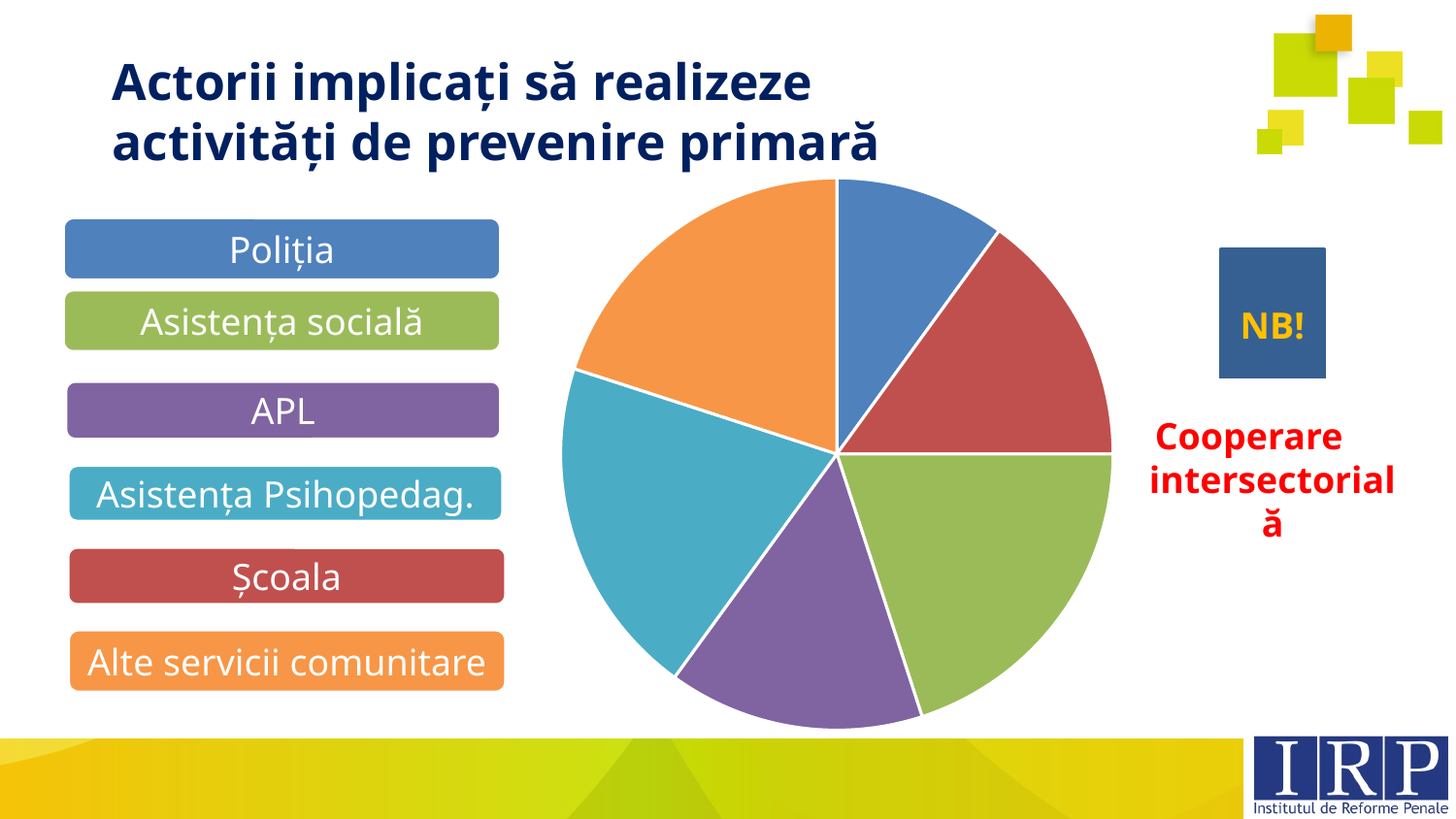
Which slice is larger, Poliția or Școala? Școala What kind of chart is shown on the slide? pie chart How many slices does the pie chart have? 6 What is the title of the slide containing the pie chart? Actorii implicați să realizeze activități de prevenire primară Which slice is larger, APL or Alte servicii comunitare? Alte servicii comunitare What colour is the slice for Școala in the pie chart? red Which category has the smallest slice in the pie chart? Poliția Which slice is larger, Poliția or Asistența Psihopedag.? Asistența Psihopedag.